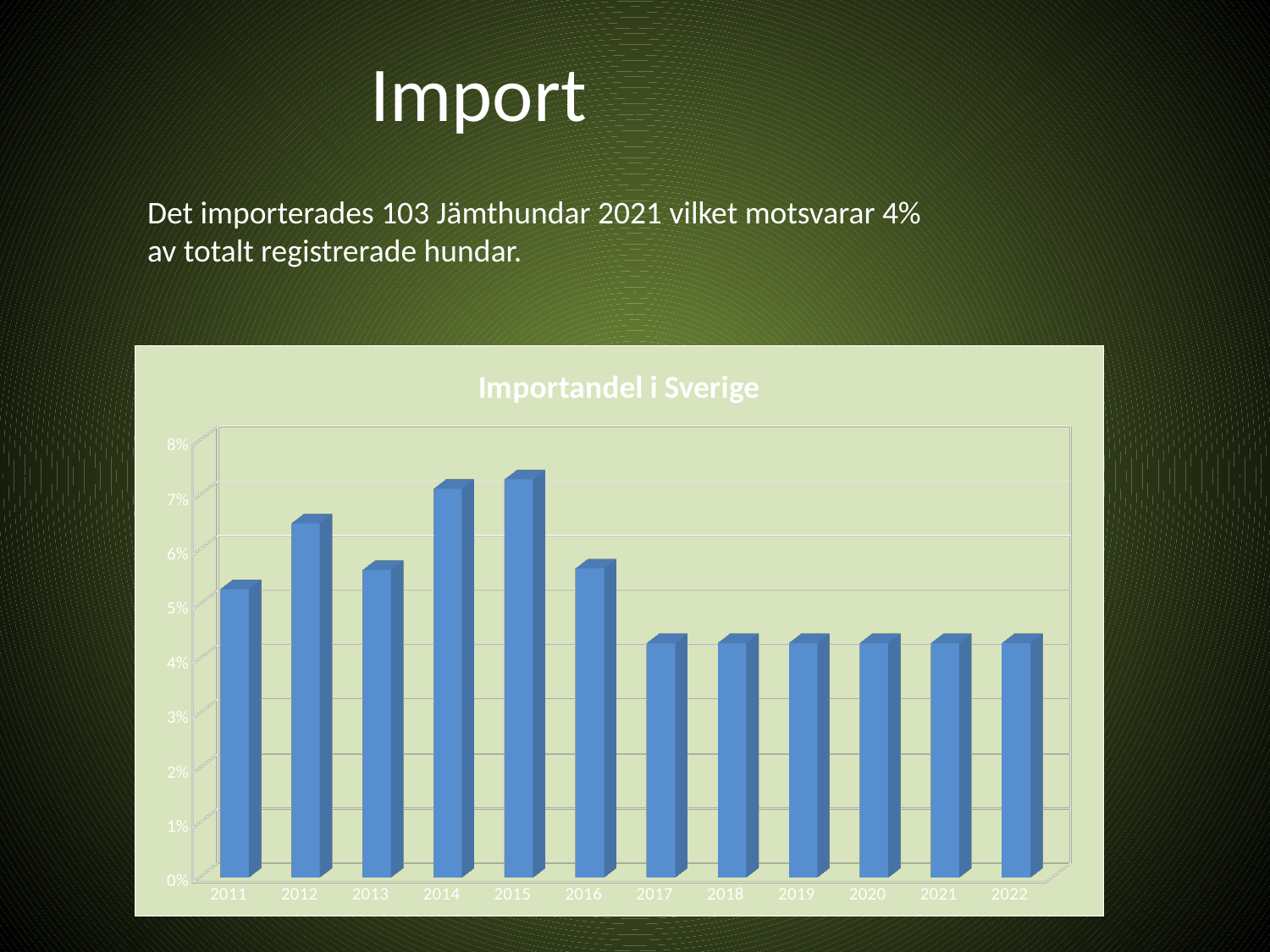
Is the value for 2012 greater or less than 6%? greater What is the highest value shown on the y axis of the chart? 8% Is the value for 2020 greater or less than 4%? greater Is the value for 2014 greater or less than 6%? greater What kind of chart is shown on the slide? bar chart How many years are shown on the x axis of the chart? 12 What is the title of the chart? Importandel i Sverige Which year has the larger value, 2014 or 2016? 2014 Which year has the larger value, 2012 or 2013? 2012 Do the values rise or fall from 2015 to 2017? fall